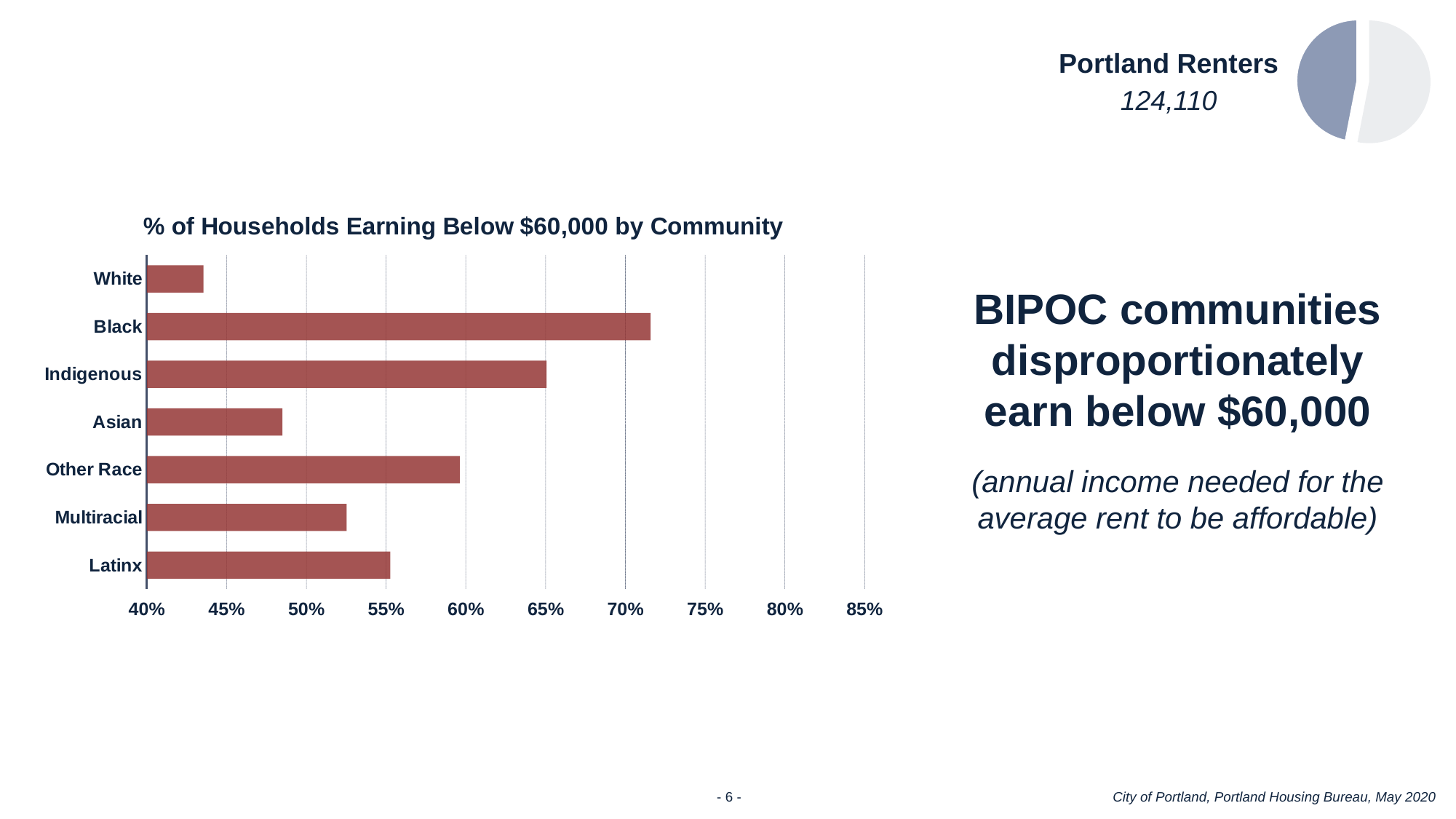
Is the value for White greater or less than 45%? less What kind of chart is shown on the slide? a bar chart and a pie chart Which community has the highest percentage of households earning below $60,000? Black Which is larger, the value for Black or the value for Indigenous? Black What is the title of the chart? % of Households Earning Below $60,000 by Community Is the value for Black greater or less than 70%? greater Which community has the lowest percentage of households earning below $60,000? White Is the value for Indigenous greater or less than 60%? greater Which is larger, the value for Latinx or the value for Multiracial? Latinx How many communities are shown in the chart? 7